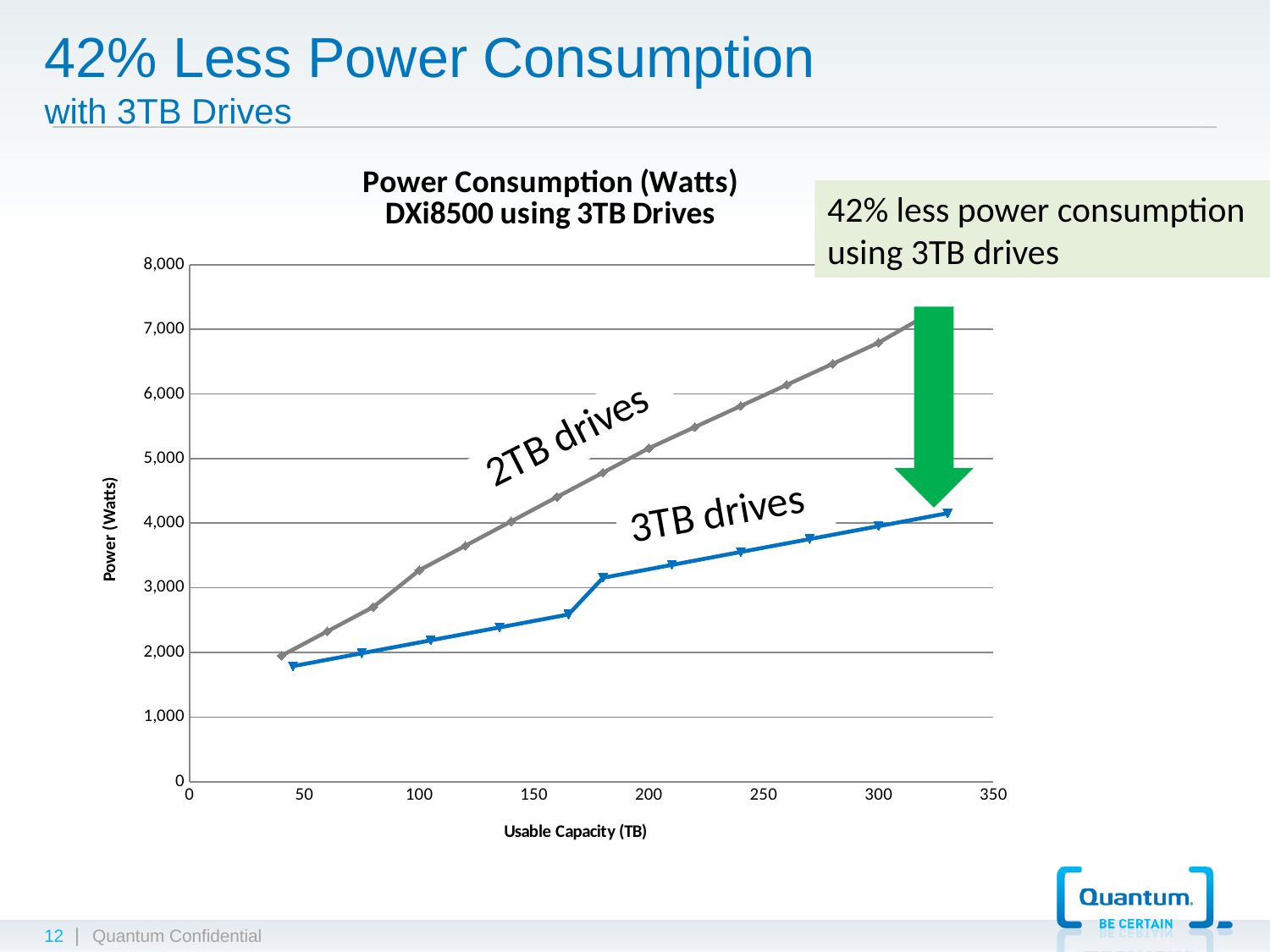
What kind of chart is shown on the slide? Line chart What is the title of the chart? Power Consumption (Watts) DXi8500 using 3TB Drives Which series reaches the highest power consumption on the chart? 2TB drives Is the power consumption for 2TB drives at 100 TB greater or less than 3,000 watts? greater Is the power consumption for 2TB drives at 300 TB greater or less than 6,000 watts? greater Does the power consumption for 2TB drives rise or fall as usable capacity increases? Rises How many data series are plotted on the chart? 2 Is the power consumption for 3TB drives at 200 TB greater or less than 4,000 watts? less Does the power consumption for 3TB drives rise or fall as usable capacity increases? Rises At 250 TB usable capacity, which series has the higher power consumption, 2TB drives or 3TB drives? 2TB drives What is the label of the vertical axis? Power (Watts)